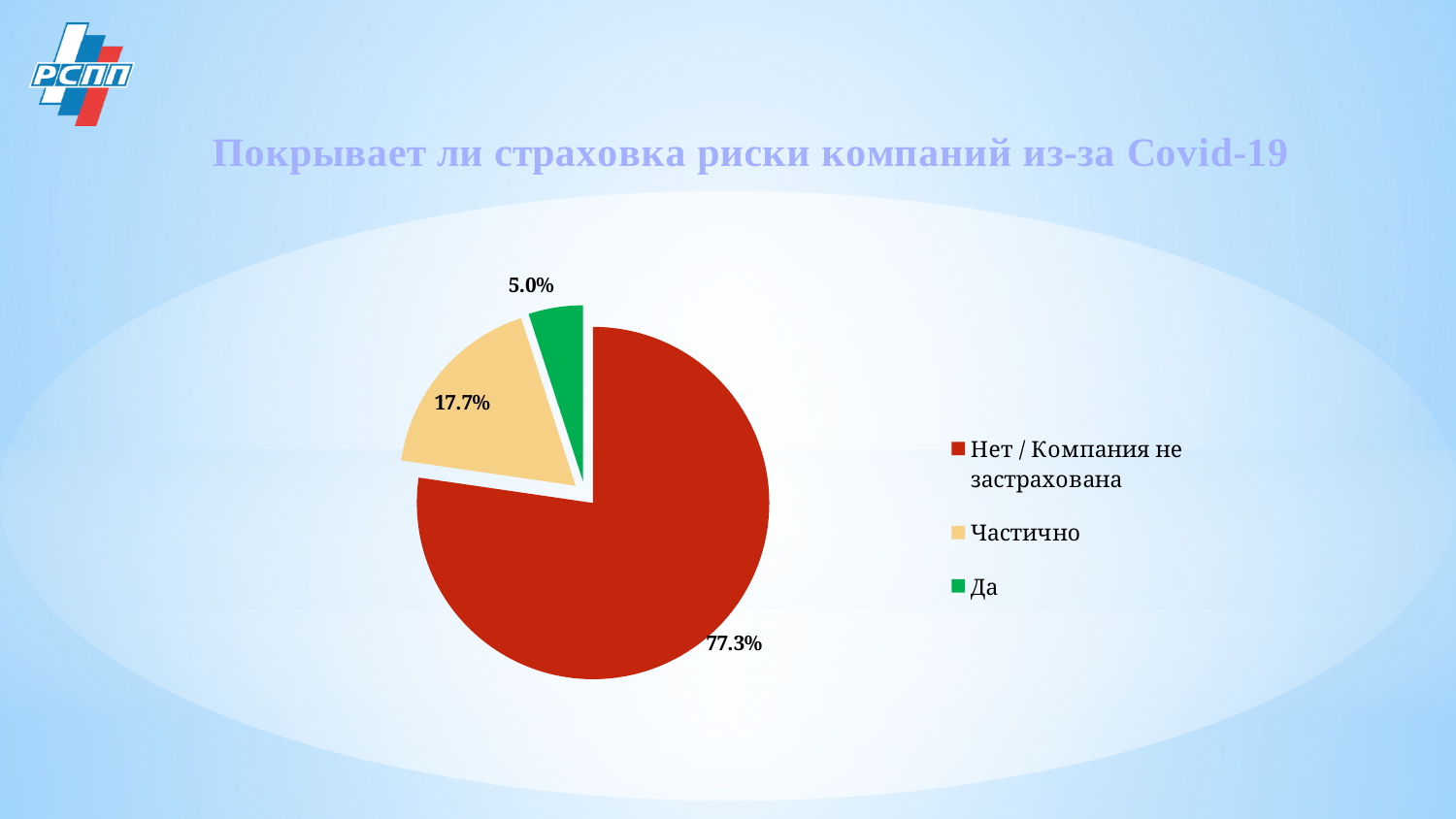
Which category has the smallest slice of the pie? Да What share of the pie does the slice "Частично" represent? 17.7% Which category has the largest slice of the pie? Нет / Компания не застрахована What share of the pie does the slice "Нет / Компания не застрахована" represent? 77.3% What is the title of the chart on the slide? Покрывает ли страховка риски компаний из-за Covid-19 What is the difference in percentage points between the "Нет / Компания не застрахована" slice and the "Частично" slice? 59.6 What share of the pie does the slice "Да" represent? 5.0% What kind of chart is shown on the slide? Pie chart Which is larger: the share for "Частично" or the share for "Да"? Частично What colour is the slice for "Да" in the pie chart? Green What is the difference in percentage points between the "Частично" slice and the "Да" slice? 12.7 How many categories does the pie chart show? 3